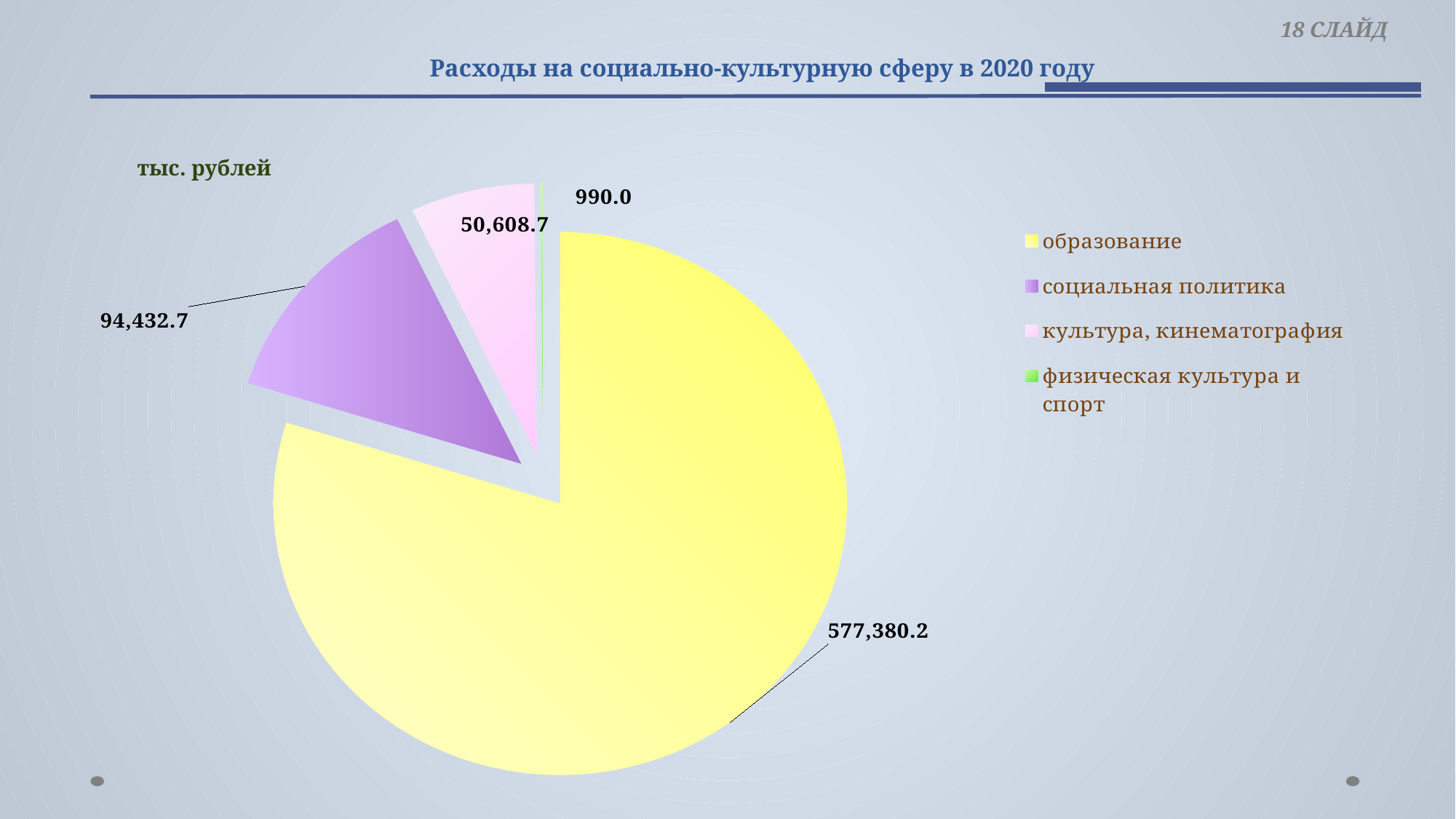
Which category has the smallest slice of the pie? физическая культура и спорт In what units are the values on the chart given? тыс. рублей What is the value for образование? 577,380.2 Which is larger, the value for социальная политика or the value for культура, кинематография? социальная политика What type of chart is shown on the slide? pie chart What is the value for социальная политика? 94,432.7 What is the value for физическая культура и спорт? 990.0 What is the value for культура, кинематография? 50,608.7 What is the difference between the values for социальная политика and культура, кинематография? 43,824.0 Which category has the largest slice of the pie? образование How many categories does the pie chart show? 4 What is the title of the chart on the slide? Расходы на социально-культурную сферу в 2020 году